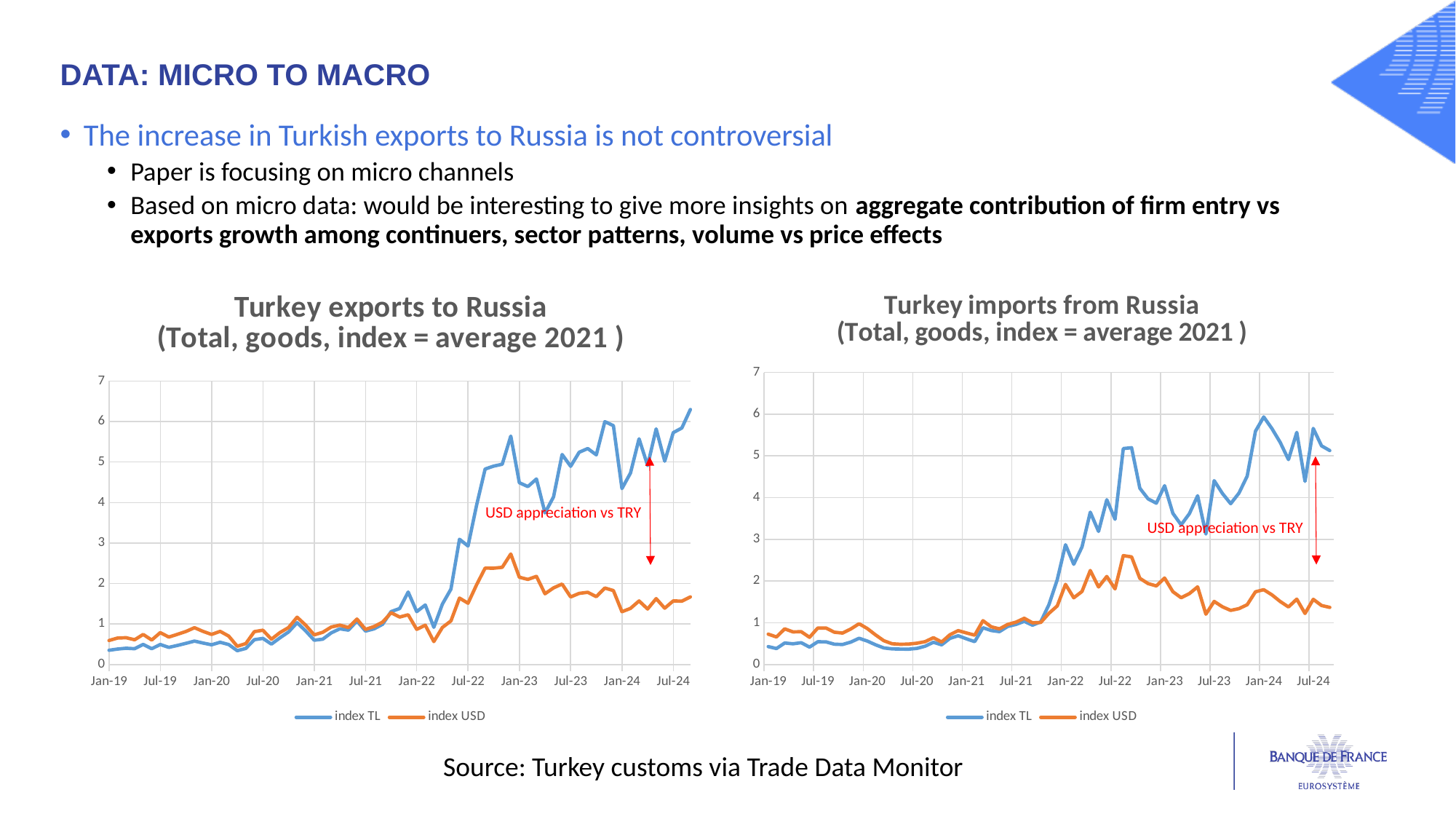
In the 'Turkey exports to Russia' chart, is the value of index TL at Jan-23 greater or less than 5? less In the 'Turkey exports to Russia' chart, is the value of index USD at Jan-23 greater or less than 3? less In the 'Turkey exports to Russia' chart, does index TL rise or fall overall between Jan-21 and Jan-23? rise In the 'Turkey imports from Russia' chart, is the value of index USD at Jul-24 greater or less than 2? less What kind of chart is the 'Turkey exports to Russia' chart on the left? line chart In the 'Turkey exports to Russia' chart, which series is higher at Jul-24, index TL or index USD? index TL How many series does the legend of the 'Turkey imports from Russia' chart list? 2 In the 'Turkey exports to Russia' chart, which series is drawn in orange? index USD In the 'Turkey imports from Russia' chart, which series is higher at Jan-23, index TL or index USD? index TL What is the highest value shown on the y axis of the 'Turkey imports from Russia' chart? 7